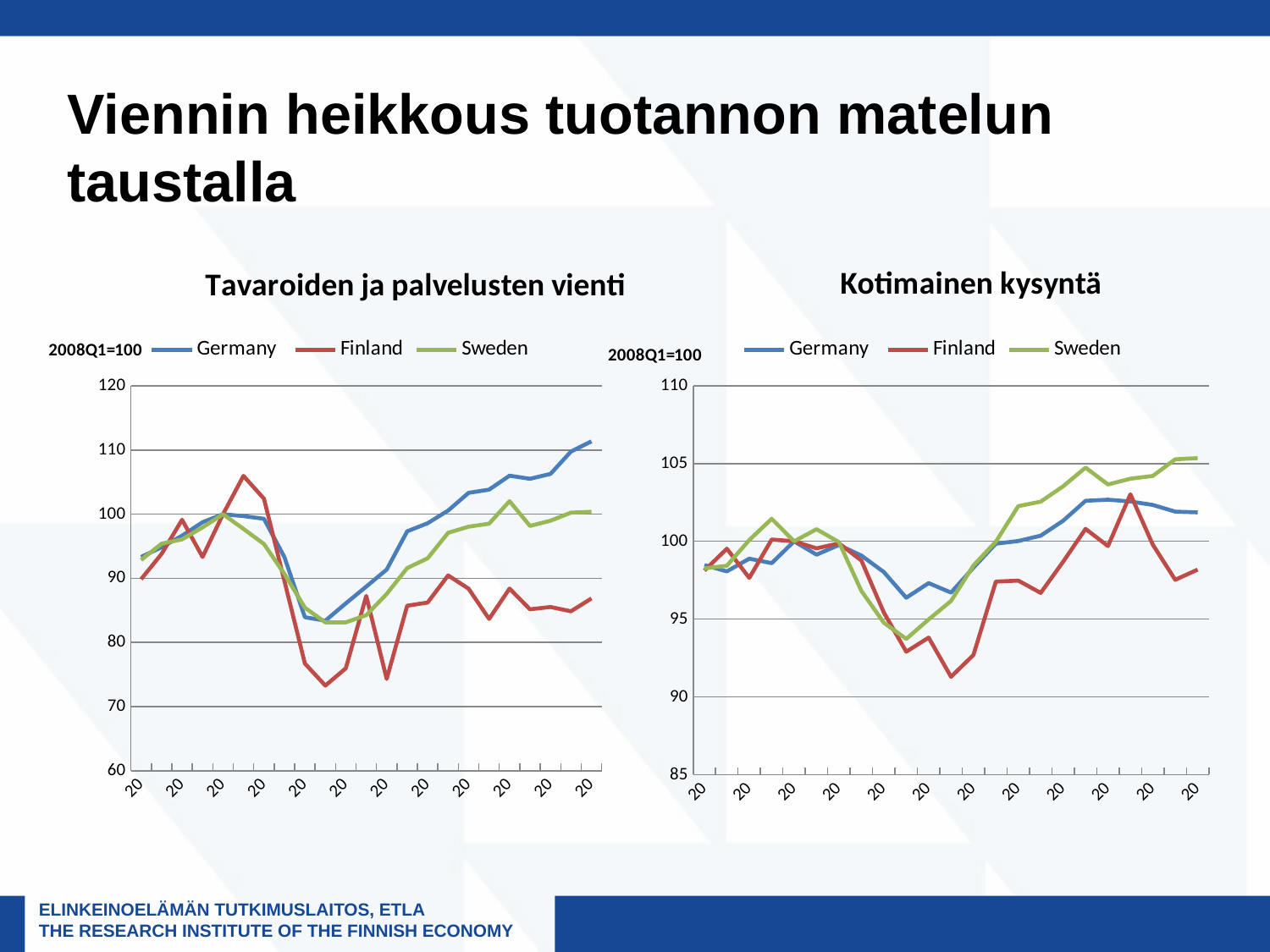
How many series does the legend of the right chart "Kotimainen kysyntä" list? 3 In the right chart "Kotimainen kysyntä", which series ends at the lowest value at the right end of the x axis? Finland What kind of chart is the left chart titled "Tavaroiden ja palvelusten vienti"? Line chart In the right chart "Kotimainen kysyntä", which series ends at the highest value at the right end of the x axis? Sweden In the left chart "Tavaroiden ja palvelusten vienti", is the final value for Finland greater or less than 90? less Which countries are listed in the legend of the left chart "Tavaroiden ja palvelusten vienti"? Germany, Finland, Sweden In the right chart "Kotimainen kysyntä", is the final value for Germany greater or less than 100? greater What base period is indicated for the index in both charts? 2008Q1=100 In the left chart "Tavaroiden ja palvelusten vienti", is the lowest point of the Finland line greater or less than 80? less In the left chart "Tavaroiden ja palvelusten vienti", which series ends at the highest value at the right end of the x axis? Germany In the left chart "Tavaroiden ja palvelusten vienti", which series ends at the lowest value at the right end of the x axis? Finland